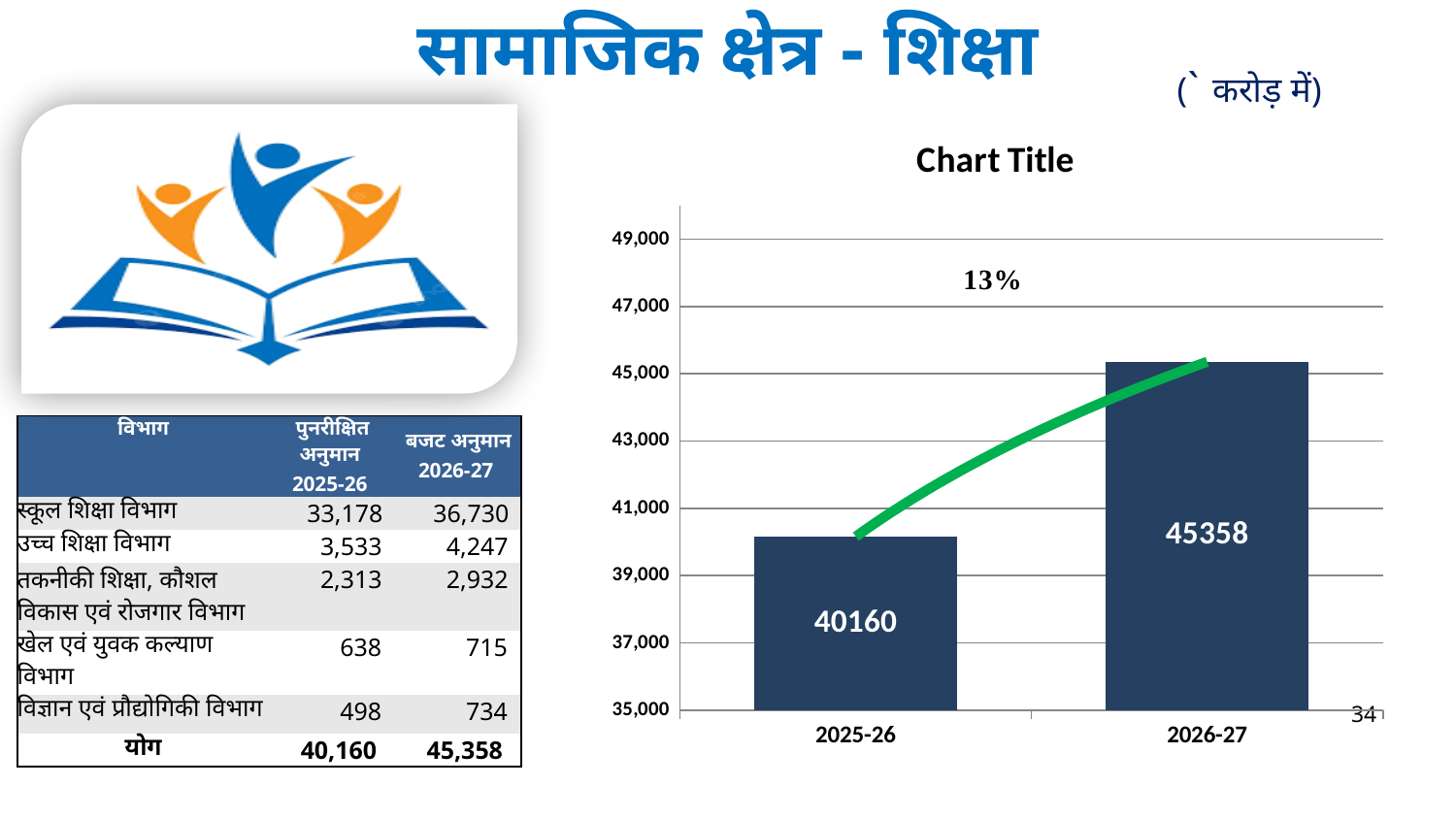
What is the difference between the 2026-27 and 2025-26 values in the chart? 5198 What is the value for 2026-27 in the chart? 45358 Is the value for 2025-26 greater or less than 41,000? less What kind of chart is shown on the slide? bar chart Do the values rise or fall from 2025-26 to 2026-27? rise Is the value for 2025-26 larger or smaller than the value for 2026-27? smaller How many bars are shown in the chart? 2 Which category has the lower value in the chart? 2025-26 What percentage is printed above the bars in the chart? 13% What is the value for 2025-26 in the chart? 40160 Which category has the higher value in the chart? 2026-27 Is the value for 2026-27 greater or less than 45,000? greater